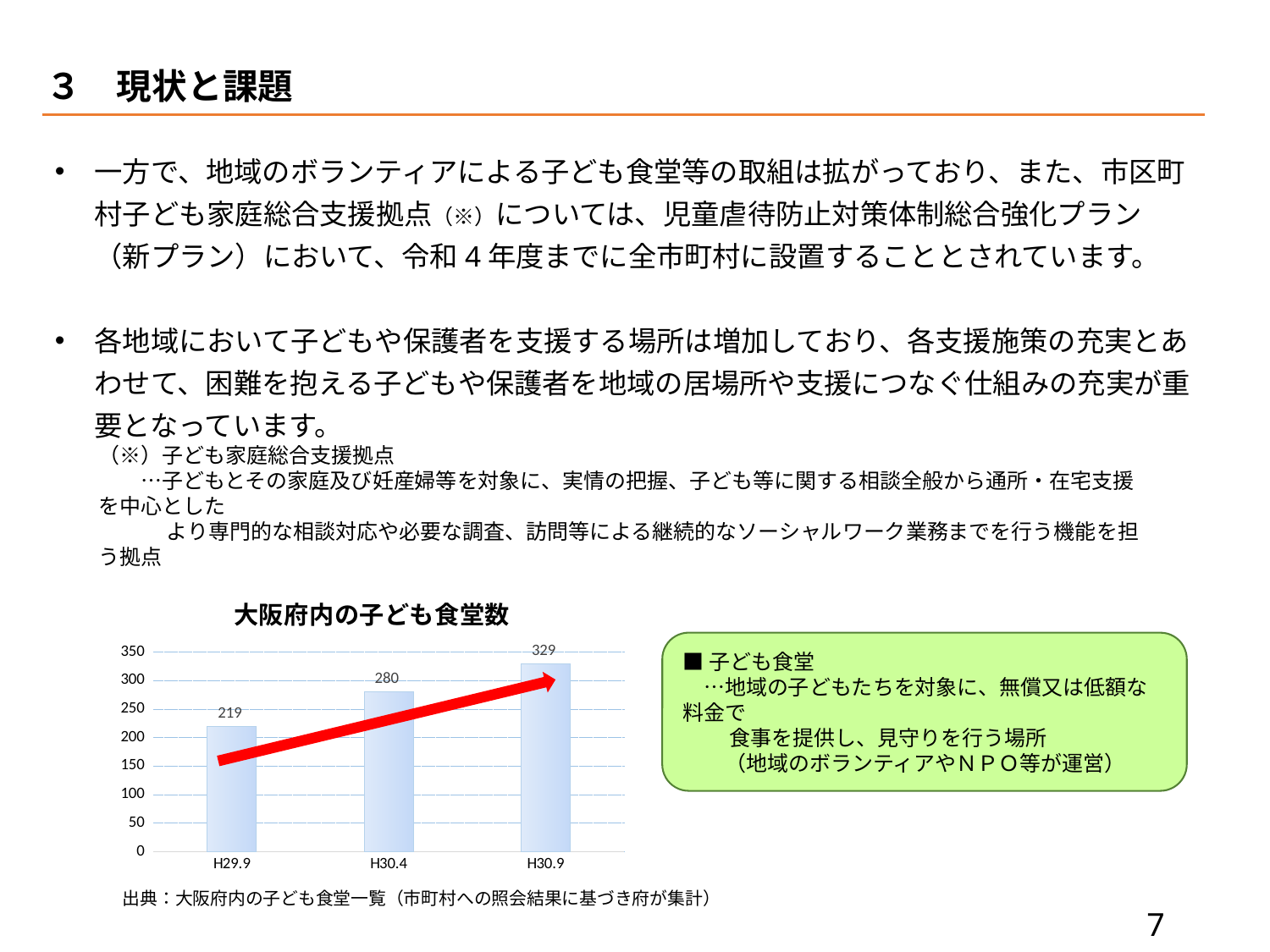
Which category has the highest value in the 大阪府内の子ども食堂数 chart? H30.9 Is the value for H29.9 in the 大阪府内の子ども食堂数 chart greater or less than 250? less What is the value for H30.4 in the 大阪府内の子ども食堂数 chart? 280 Do the values in the 大阪府内の子ども食堂数 chart rise or fall from H29.9 to H30.9? rise How many categories are shown on the x axis of the 大阪府内の子ども食堂数 chart? 3 Which category has the lowest value in the 大阪府内の子ども食堂数 chart? H29.9 What is the difference between the values for H30.9 and H29.9 in the 大阪府内の子ども食堂数 chart? 110 What is the value for H30.9 in the 大阪府内の子ども食堂数 chart? 329 What is the difference between the values for H30.4 and H29.9 in the 大阪府内の子ども食堂数 chart? 61 What is the value for H29.9 in the 大阪府内の子ども食堂数 chart? 219 What kind of chart is the 大阪府内の子ども食堂数 chart? bar chart Which is larger in the 大阪府内の子ども食堂数 chart, the value for H30.4 or the value for H30.9? H30.9